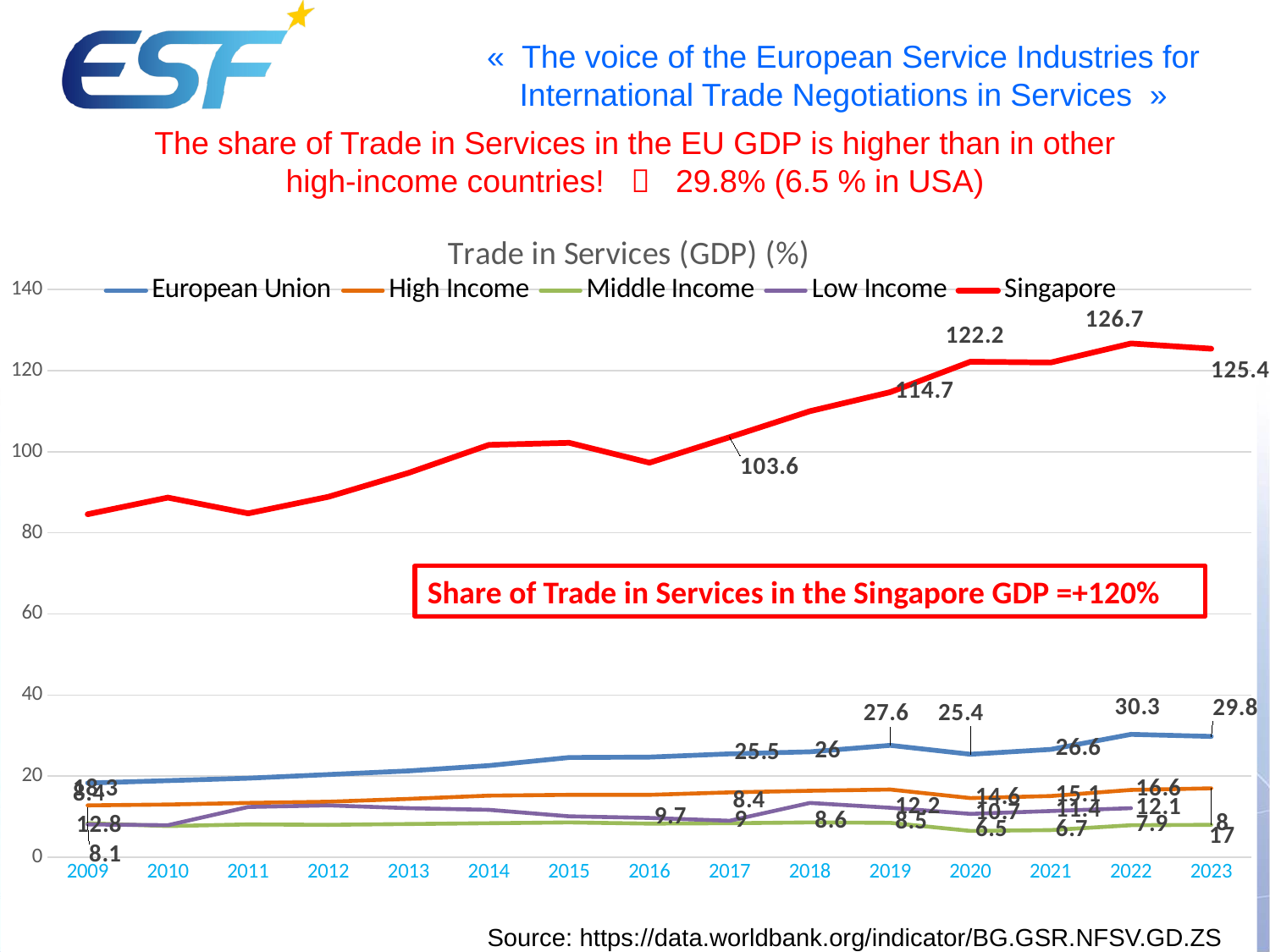
In which year does Singapore reach its highest value? 2022 Which series has the highest values across the whole chart? Singapore How many series does the chart legend list? 5 What is the value for Singapore in 2022? 126.7 Does the Singapore line generally rise or fall from 2009 to 2023? Rise What is the title of the chart? Trade in Services (GDP) (%) What is the value for the European Union in 2023? 29.8 What type of chart is shown on the slide? Line chart How many years are shown on the x axis of the chart? 15 What is the value for Singapore in 2023? 125.4 Is the value for Singapore in 2009 greater or less than 100? less What is the difference between Singapore's values in 2022 and 2023? 1.3